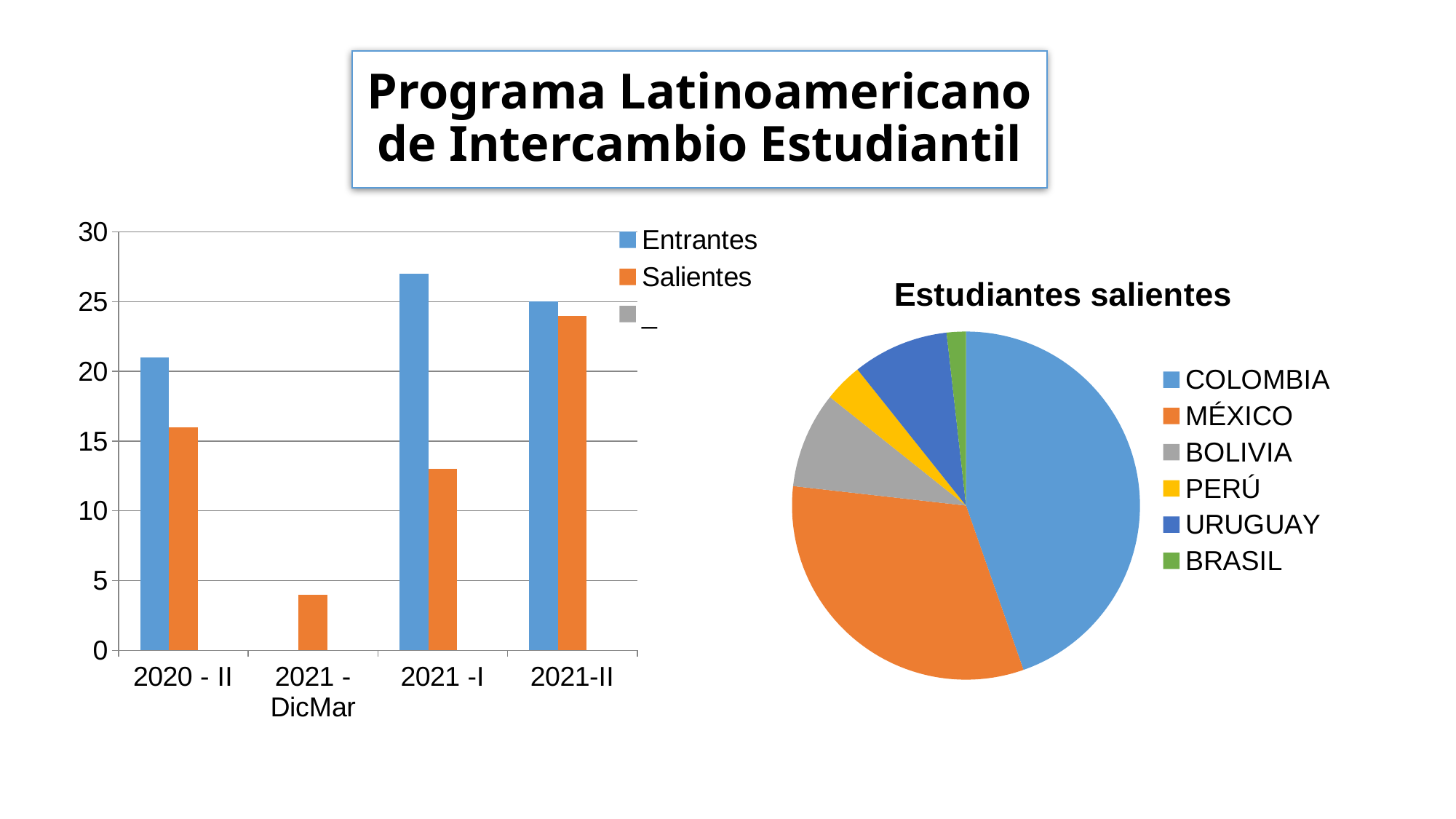
In the 'Estudiantes salientes' pie chart, how many countries does the legend list? 6 In the 'Estudiantes salientes' pie chart, which country has the largest slice? COLOMBIA In the bar chart on the left, is the Salientes value for 2021 -I greater or less than 15? less In the bar chart on the left, is the Salientes value for 2021 - DicMar greater or less than 5? less In the bar chart on the left, which period has the lowest Salientes value? 2021 - DicMar In the bar chart on the left, which period has the highest Salientes value? 2021-II What kind of chart is the 'Estudiantes salientes' chart? pie chart In the bar chart on the left, for 2020 - II, which is larger: Entrantes or Salientes? Entrantes In the bar chart on the left, how many periods are shown on the x axis? 4 In the bar chart on the left, which period has the highest Entrantes value? 2021 -I In the bar chart on the left, is the Entrantes value for 2020 - II greater or less than 20? greater What kind of chart is the chart on the left of the slide? bar chart